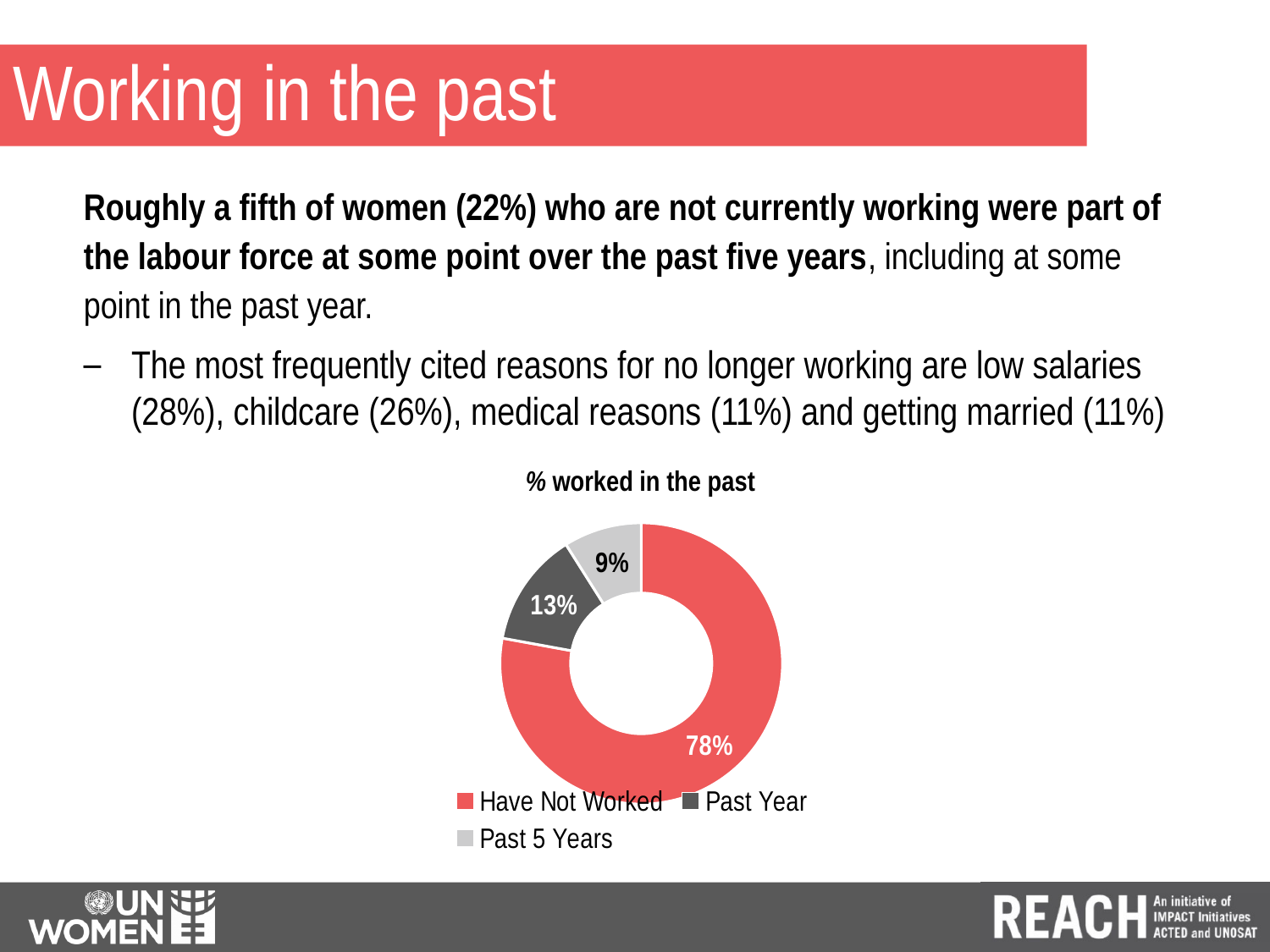
What percentage of the chart is labelled "Past Year"? 13% What is the difference between the "Have Not Worked" and "Past Year" shares? 65% What is the difference between the "Past Year" and "Past 5 Years" shares? 4% Which is larger, the share for "Past Year" or the share for "Past 5 Years"? Past Year What percentage of the chart is labelled "Have Not Worked"? 78% What is the title of the chart? % worked in the past How many categories does the chart show? 3 What percentage of the chart is labelled "Past 5 Years"? 9% What kind of chart is shown on the slide? Doughnut chart Which category has the largest share of the chart? Have Not Worked What colour is the "Have Not Worked" segment in the chart? Red Which category has the smallest share of the chart? Past 5 Years